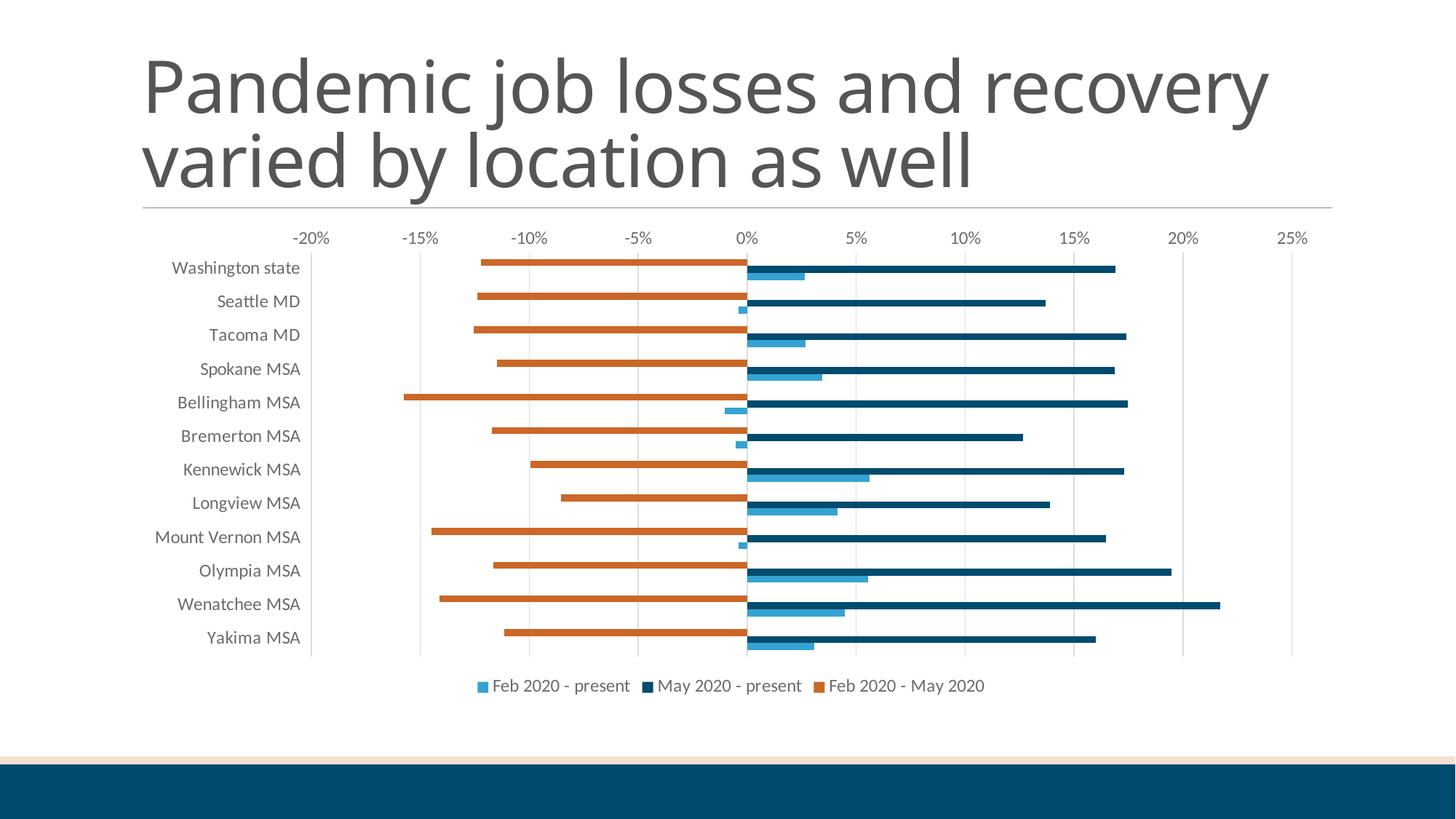
Which location has the lowest (most negative) value for the Feb 2020 - May 2020 series? Bellingham MSA Is the Feb 2020 - May 2020 value for Bellingham MSA greater or less than -15%? less For the May 2020 - present series, which is larger: Wenatchee MSA or Yakima MSA? Wenatchee MSA Which location has the least negative value for the Feb 2020 - May 2020 series? Longview MSA Is the Feb 2020 - present value for Yakima MSA greater or less than 5%? less What is the title of the slide? Pandemic job losses and recovery varied by location as well How many locations are listed on the chart? 12 What kind of chart is shown on the slide? bar chart Is the May 2020 - present value for Washington state greater or less than 15%? greater Which location has the highest value for the May 2020 - present series? Wenatchee MSA How many series does the legend list? 3